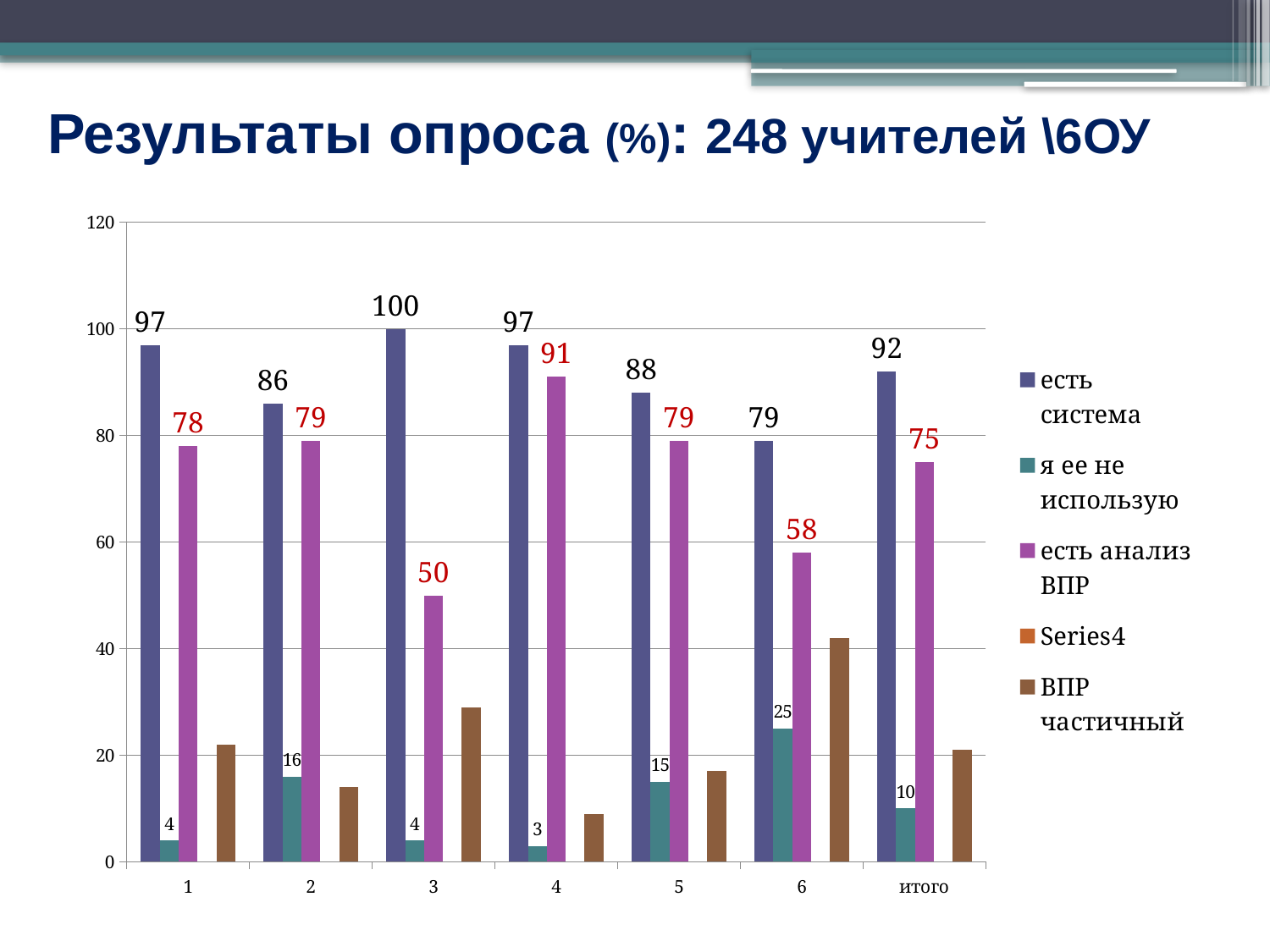
What is the value of "я ее не использую" for category 6? 25 What is the value of "есть система" for category 3? 100 Which category has the lowest value for "есть анализ ВПР"? 3 What is the value of "есть анализ ВПР" for category 4? 91 What kind of chart is shown on the slide? bar chart What is the difference between "есть система" and "есть анализ ВПР" for category 3? 50 How many series does the legend list? 5 What is the value of "есть система" for "итого"? 92 Which category has the highest value for "есть система"? 3 Which is larger for category 6: "есть система" or "есть анализ ВПР"? есть система How many categories are shown on the x axis? 7 Is the value of "ВПР частичный" for category 6 greater or less than 40? greater